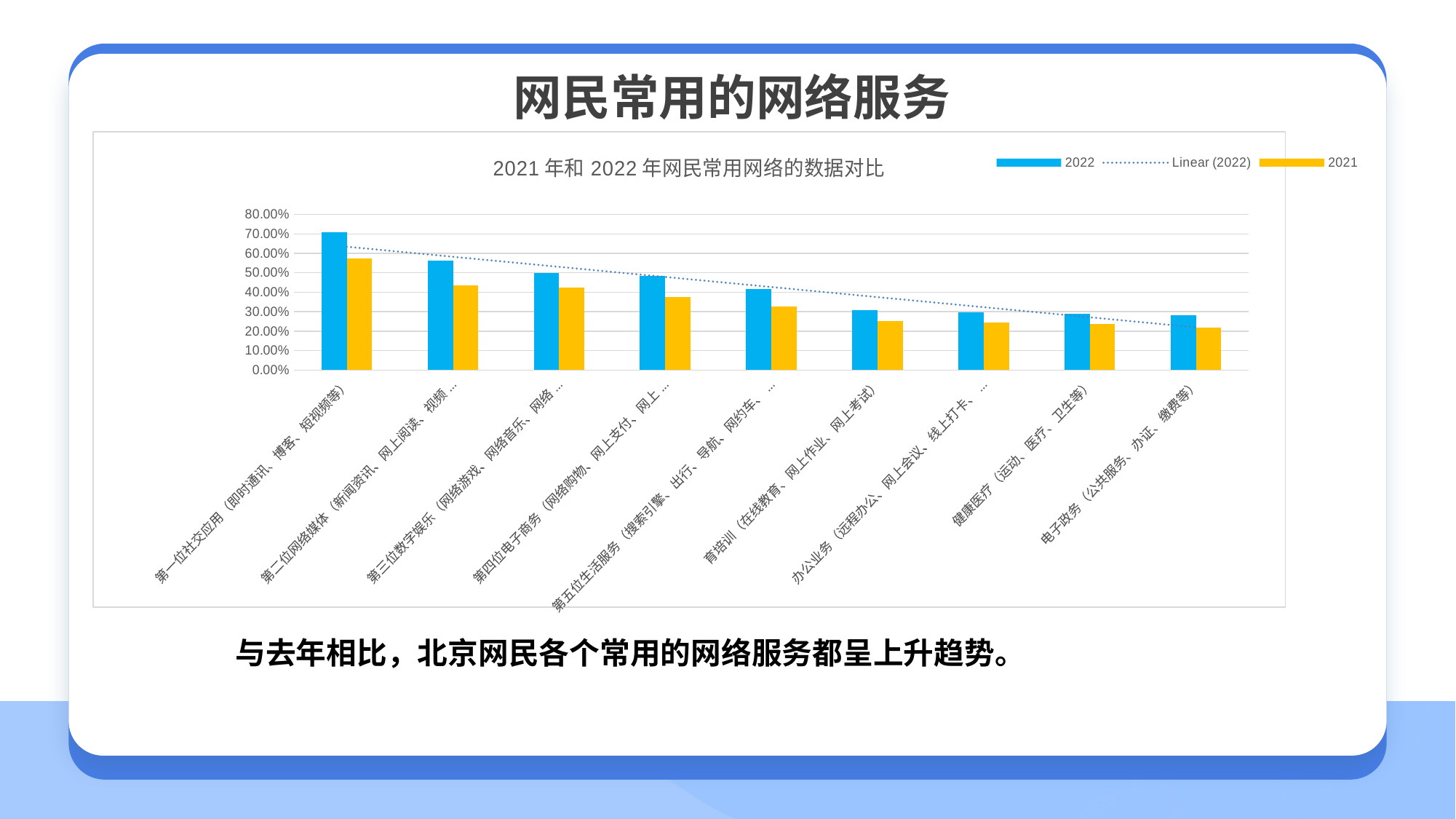
How many entries does the chart's legend list? 3 What is the title of the chart? 2021 年和 2022 年网民常用网络的数据对比 Do the 2022 values rise or fall moving from left to right along the x axis? fall For 健康医疗, which series has the larger value, 2022 or 2021? 2022 Is the 2021 value for 电子政务 greater or less than 30.00%? less Is the 2022 value for 第二位网络媒体 greater or less than 50.00%? greater Is the 2021 value for 第一位社交应用 greater or less than 50.00%? greater What kind of chart is shown on the slide? bar chart Which category has the highest 2022 value? 第一位社交应用（即时通讯、博客、短视频等） How many categories are plotted along the x axis of the chart? 9